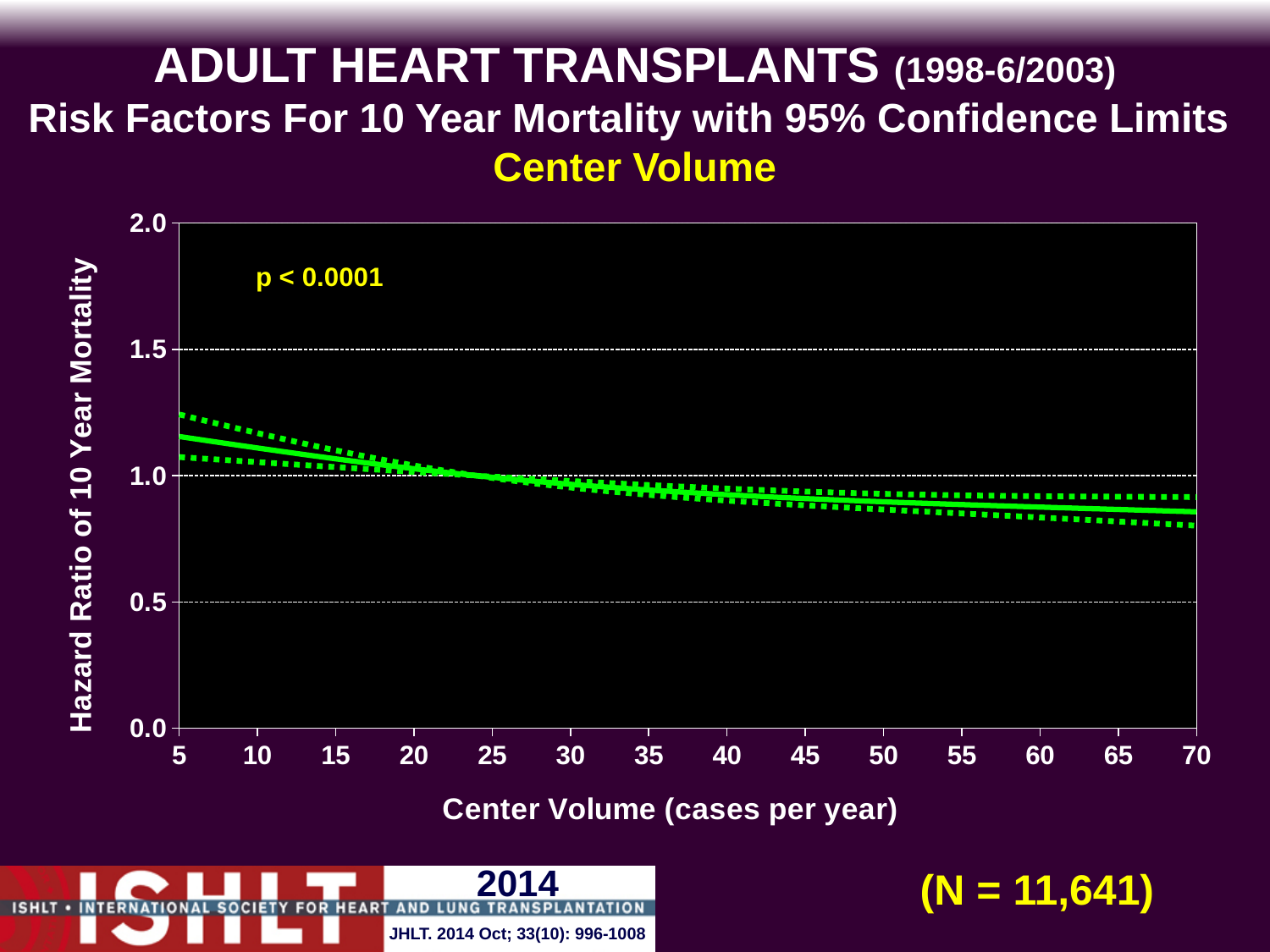
What is the highest value labeled on the y axis? 2.0 How many tick marks are labeled on the x axis? 14 Is the lower confidence limit at a center volume of 70 cases per year greater or less than 0.5? greater Does the hazard ratio of 10 year mortality rise or fall as center volume increases along the x axis? fall What p-value is printed on the chart? p < 0.0001 Is the hazard ratio on the solid line at a center volume of 70 cases per year greater or less than 1.0? less What kind of chart is shown on the slide? line chart Which has the larger hazard ratio on the solid line: a center volume of 10 or a center volume of 60 cases per year? 10 How many lines (solid and dotted) are plotted on the chart? 3 Is the upper confidence limit at a center volume of 5 cases per year greater or less than 1.5? less What is the label of the x axis? Center Volume (cases per year)